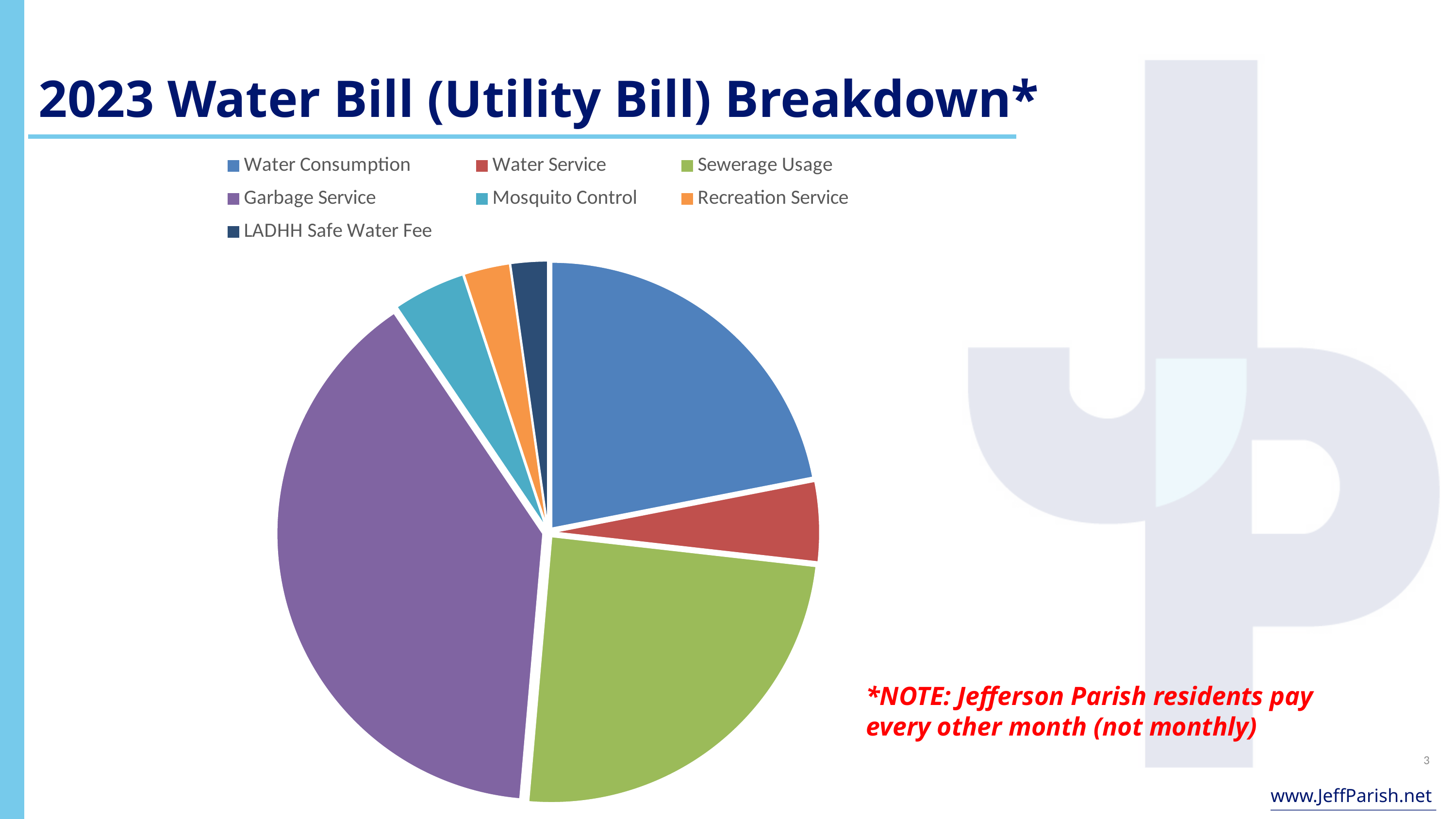
Which is larger, the slice for Garbage Service or the slice for Sewerage Usage? Garbage Service Which is larger, the slice for Water Consumption or the slice for LADHH Safe Water Fee? Water Consumption What kind of chart is shown on the slide? pie chart Which category is shown in purple in the pie chart? Garbage Service Which is larger, the slice for Water Consumption or the slice for Mosquito Control? Water Consumption What is the title of the slide containing the pie chart? 2023 Water Bill (Utility Bill) Breakdown* How many entries does the legend list? 7 Which category has the largest slice of the pie? Garbage Service How many slices does the pie chart have? 7